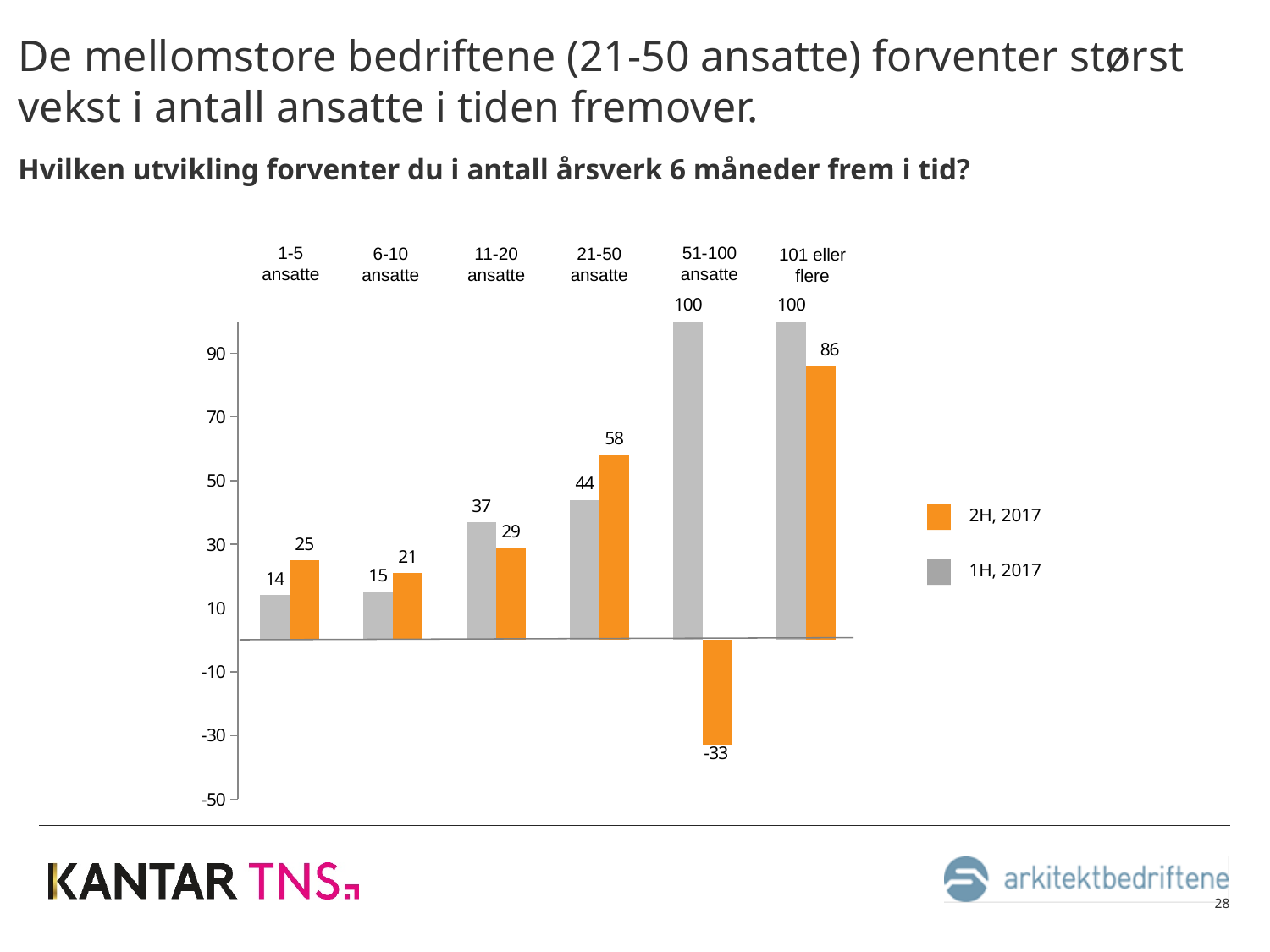
How many categories are shown on the x axis? 6 What is the difference between the 2H, 2017 and 1H, 2017 values for 21-50 ansatte? 14 What is the 1H, 2017 value for 11-20 ansatte? 37 What is the difference between the 1H, 2017 and 2H, 2017 values for 101 eller flere? 14 How many series does the legend list? 2 Which is larger for 11-20 ansatte, the 1H, 2017 value or the 2H, 2017 value? 1H, 2017 Which is larger for 1-5 ansatte, the 1H, 2017 value or the 2H, 2017 value? 2H, 2017 Which category has the lowest 2H, 2017 value? 51-100 ansatte What is the 2H, 2017 value for 21-50 ansatte? 58 What kind of chart is shown on the slide? Bar chart Which category has the highest 2H, 2017 value? 101 eller flere What is the 2H, 2017 value for 51-100 ansatte? -33